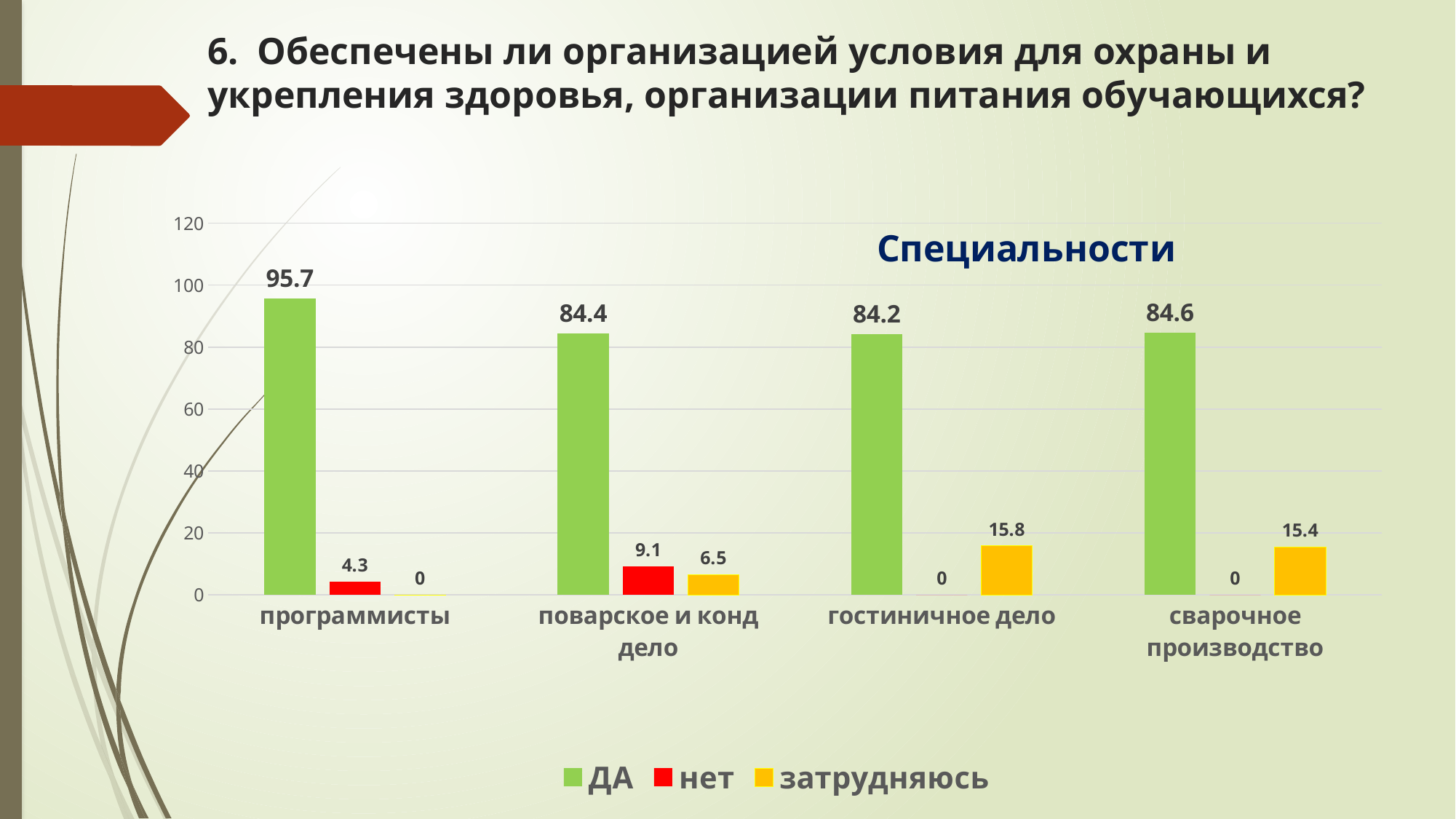
Is the ДА value for сварочное производство greater or less than 80? greater What is the value of ДА for программисты? 95.7 Which category has the highest ДА value? программисты What is the difference between the ДА values for программисты and поварское и конд дело? 11.3 Which is larger: the затрудняюсь value for гостиничное дело or for сварочное производство? гостиничное дело How many series does the legend list? 3 Which category has the lowest ДА value? гостиничное дело What is the value of затрудняюсь for сварочное производство? 15.4 What kind of chart is shown on the slide? bar chart What is the value of затрудняюсь for гостиничное дело? 15.8 How many categories are shown on the x axis? 4 What is the value of нет for поварское и конд дело? 9.1